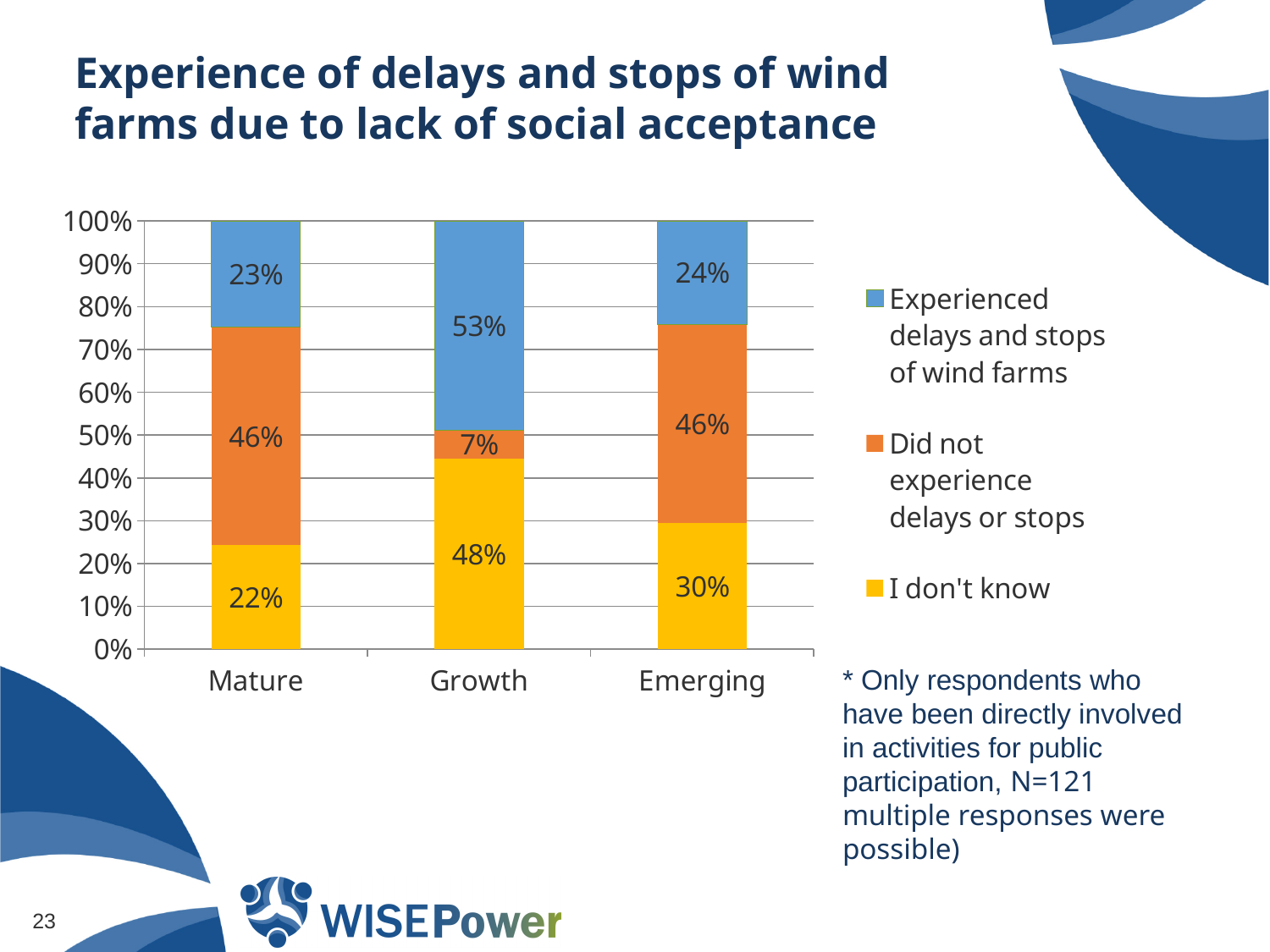
What is the value for 'I don't know' in the Emerging category? 30% Which is larger: the 'Experienced delays and stops of wind farms' value for Emerging or for Mature? Emerging Which category has the highest share of respondents who experienced delays and stops of wind farms? Growth Which colour represents 'I don't know' in the chart? Yellow Which category has the lowest share of respondents who did not experience delays or stops? Growth How many series does the legend list? 3 What percentage of respondents in the Mature category did not experience delays or stops? 46% What percentage of respondents in the Growth category experienced delays and stops of wind farms? 53% How many categories are shown on the x axis? 3 What is the difference between the 'I don't know' values for Growth and Mature? 26% What kind of chart is shown on the slide? Stacked bar chart What is the value for 'Did not experience delays or stops' in the Growth category? 7%